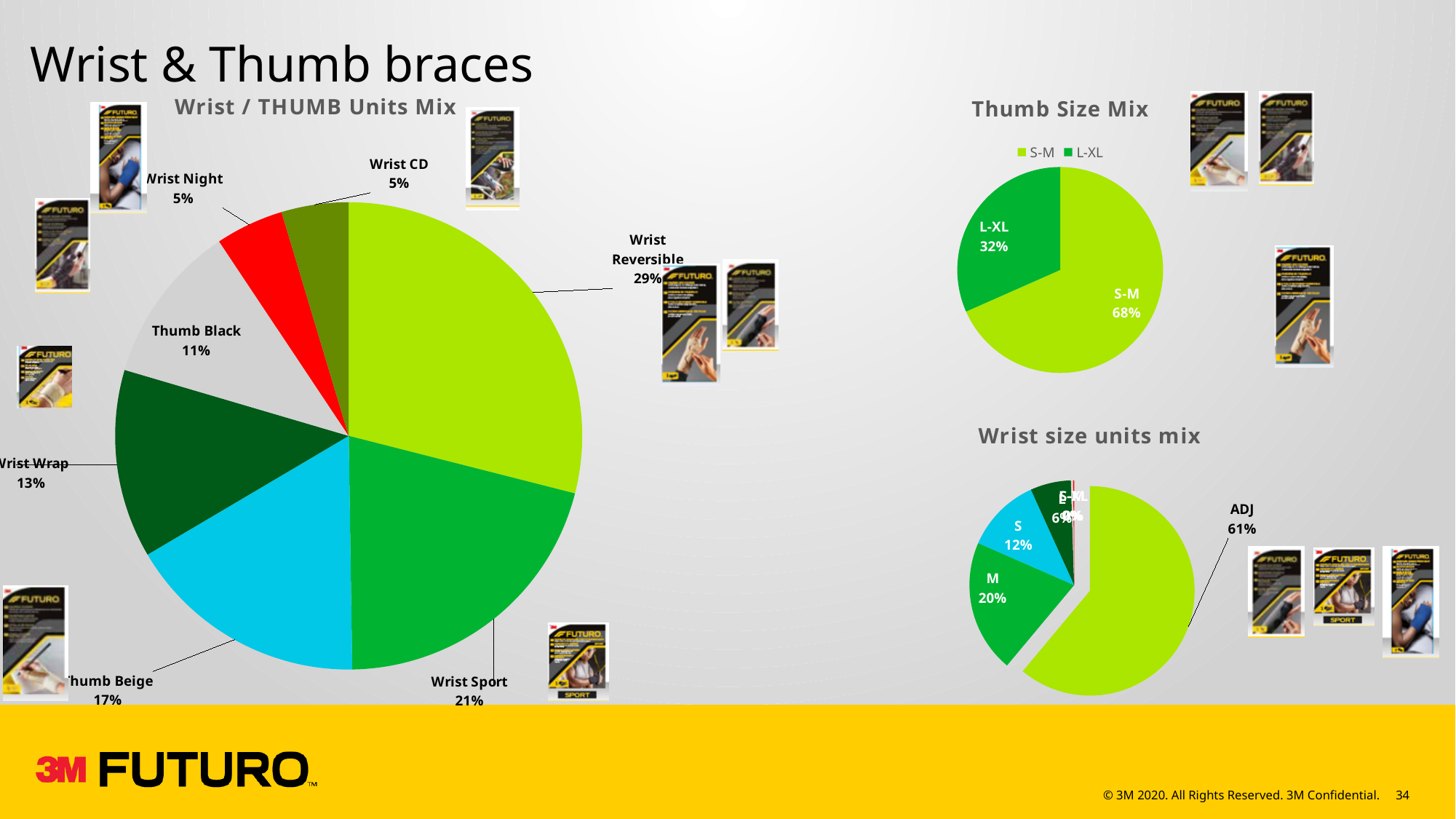
In the Wrist size units mix chart, what share does ADJ have? 61% How many entries does the legend of the Thumb Size Mix chart list? 2 In the Thumb Size Mix chart, which size has the larger share? S-M In the Wrist / THUMB Units Mix chart, what share does Thumb Beige have? 17% In the Wrist / THUMB Units Mix chart, which is larger, Thumb Black or Thumb Beige? Thumb Beige In the Wrist size units mix chart, what is the difference in percentage points between M and S? 8 In the Wrist / THUMB Units Mix chart, what is the difference in percentage points between Wrist Sport and Wrist Wrap? 8 How many categories are shown in the Wrist / THUMB Units Mix chart? 7 In the Wrist / THUMB Units Mix chart, what share does Wrist Reversible have? 29% What kind of chart is the Wrist / THUMB Units Mix chart? Pie chart In the Thumb Size Mix chart, what share does L-XL have? 32% In the Wrist / THUMB Units Mix chart, which category has the largest share? Wrist Reversible